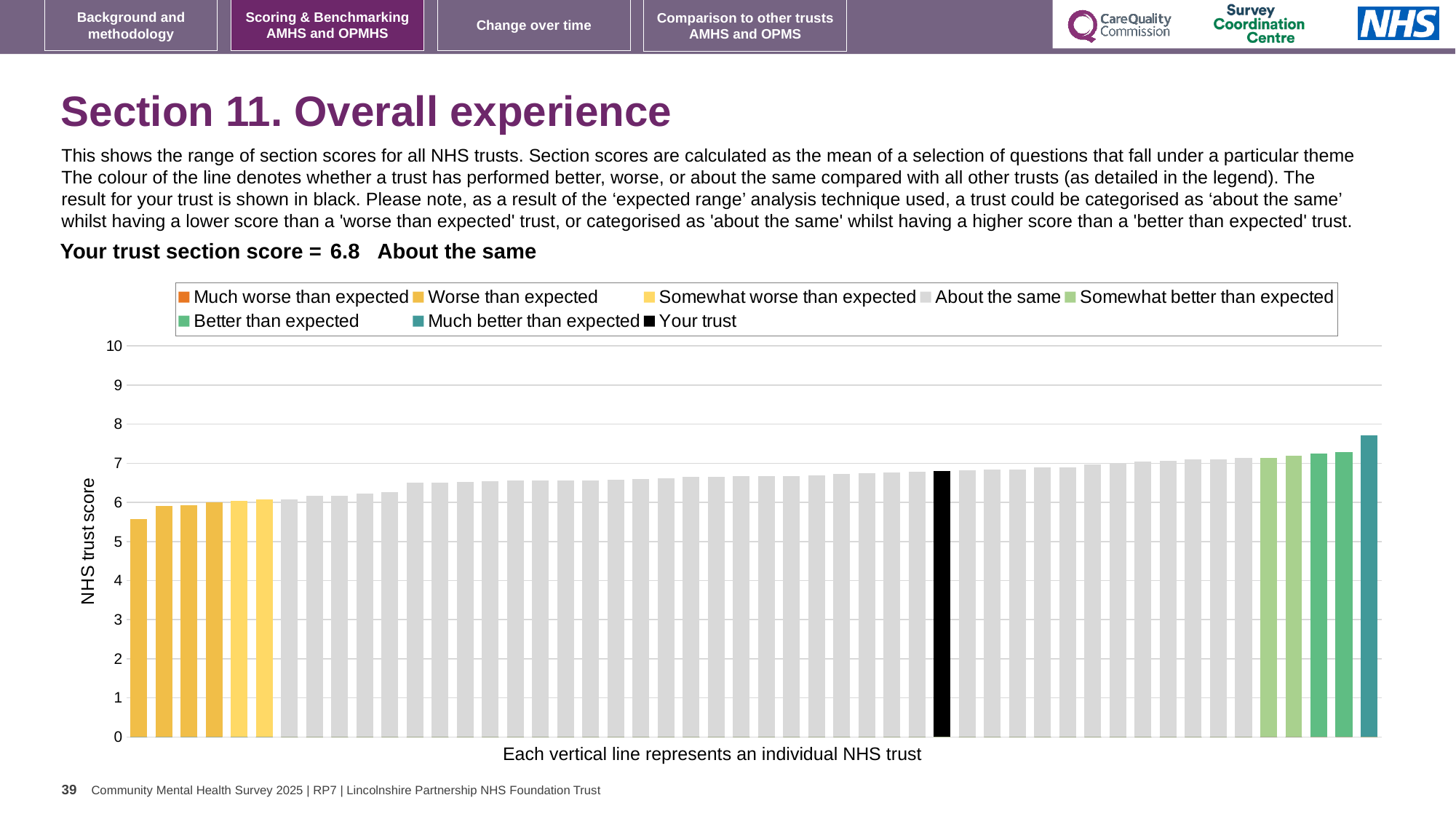
Is the value of the shortest bar (the leftmost bar) greater or less than 5? greater Is the value of the black 'Your trust' bar greater or less than 6? greater Is the value of the shortest bar (the leftmost bar) greater or less than 6? less Do the bar values rise or fall moving from left to right along the x axis? rise Is the 'Your trust' bar higher or lower than the leftmost bar? higher Which legend category does the tallest bar belong to? Much better than expected How many entries does the chart legend list? 8 What is the section score for your trust shown on the slide? 6.8 What is the label on the vertical axis of the chart? NHS trust score Which legend category does the shortest bar belong to? Worse than expected What kind of chart is shown on the slide? bar chart